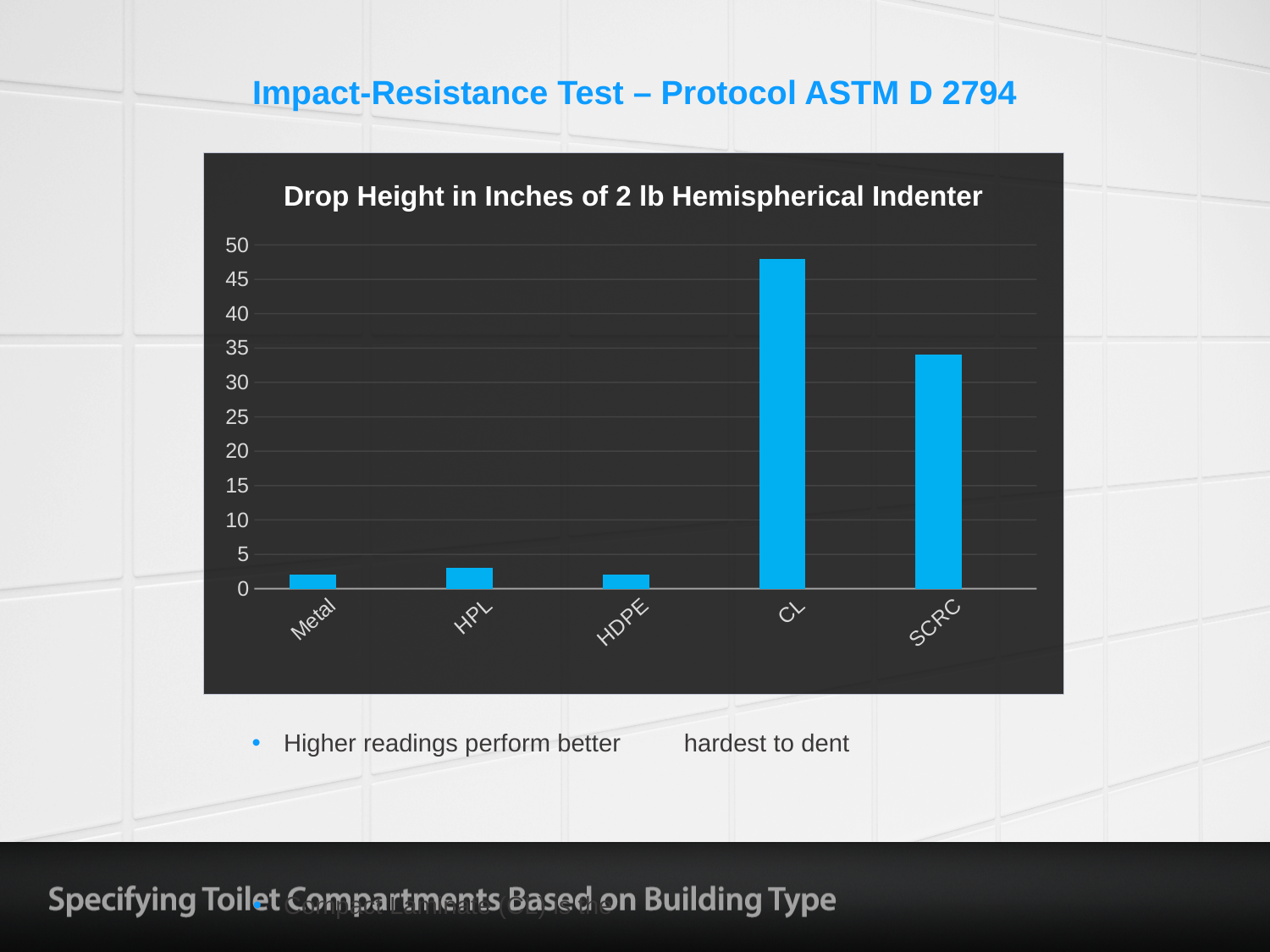
Which is larger, the value for CL or the value for SCRC? CL Is the value for HPL greater or less than 5? less Which is larger, the value for SCRC or the value for HPL? SCRC What is the highest value shown on the y axis of the chart? 50 Is the value for SCRC greater or less than 40? less What kind of chart is shown on the slide? bar chart Is the value for SCRC greater or less than 30? greater Which category has the highest drop height? CL How many categories are shown on the x axis of the chart? 5 What is the title of the chart? Drop Height in Inches of 2 lb Hemispherical Indenter